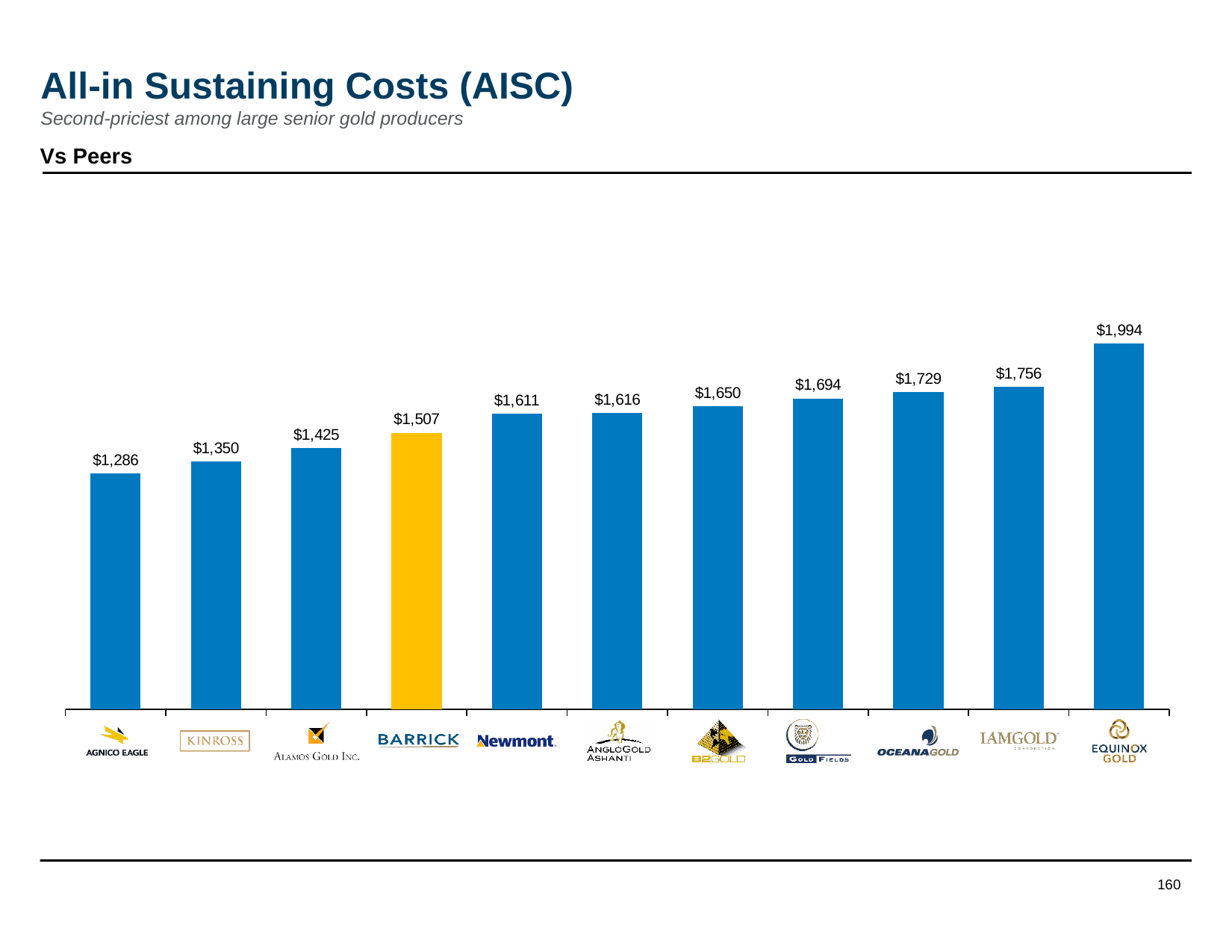
Which has a higher AISC, IAMGOLD or OceanaGold? IAMGOLD Which company has the highest AISC on the chart? Equinox Gold What is the difference between the AISC of Barrick and Kinross? $157 What is the difference between the AISC of Equinox Gold and Agnico Eagle? $708 How many companies are shown on the chart? 11 What is the AISC value shown for Newmont? $1,611 What is the AISC value shown for Barrick? $1,507 Which bar is highlighted in a different colour (yellow) from the others? Barrick Which company has the lowest AISC on the chart? Agnico Eagle What type of chart is shown on the slide? Bar chart What is the AISC value shown for Gold Fields? $1,694 What is the AISC value shown for Agnico Eagle? $1,286